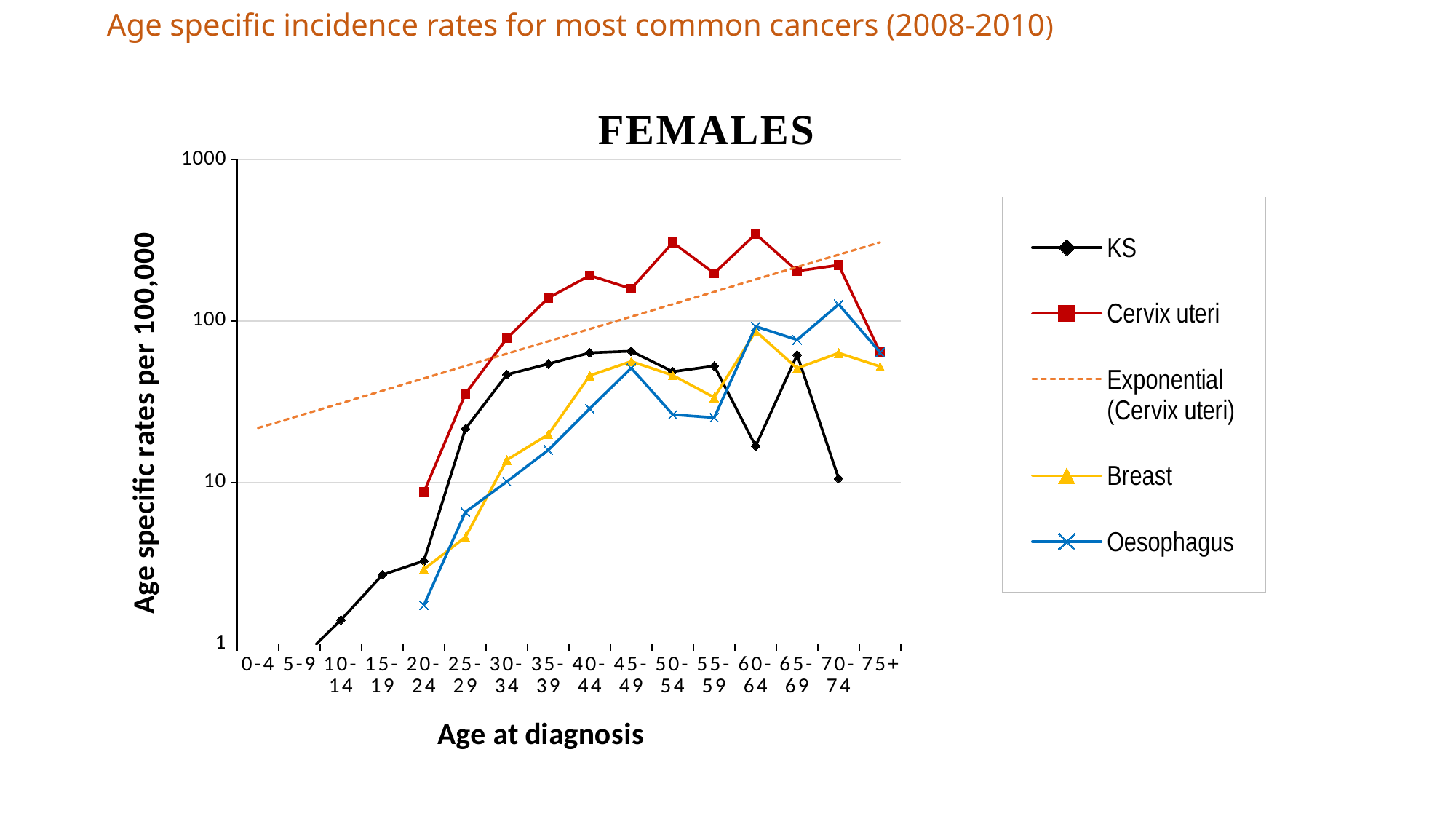
Is the value for Cervix uteri at age 60-64 greater or less than 100? greater What kind of chart is shown on the slide? line chart Is the value for KS at age 60-64 greater or less than 100? less Which series has the highest value at age 60-64? Cervix uteri Does the Cervix uteri series rise or fall from age 70-74 to 75+? fall Is the value for Oesophagus at age 70-74 greater or less than 100? greater What is the y-axis title of the chart? Age specific rates per 100,000 Which is larger at age 70-74, the value for Oesophagus or the value for KS? Oesophagus How many age groups are shown on the x axis? 16 What is the title of the chart? FEMALES How many series does the legend list? 5